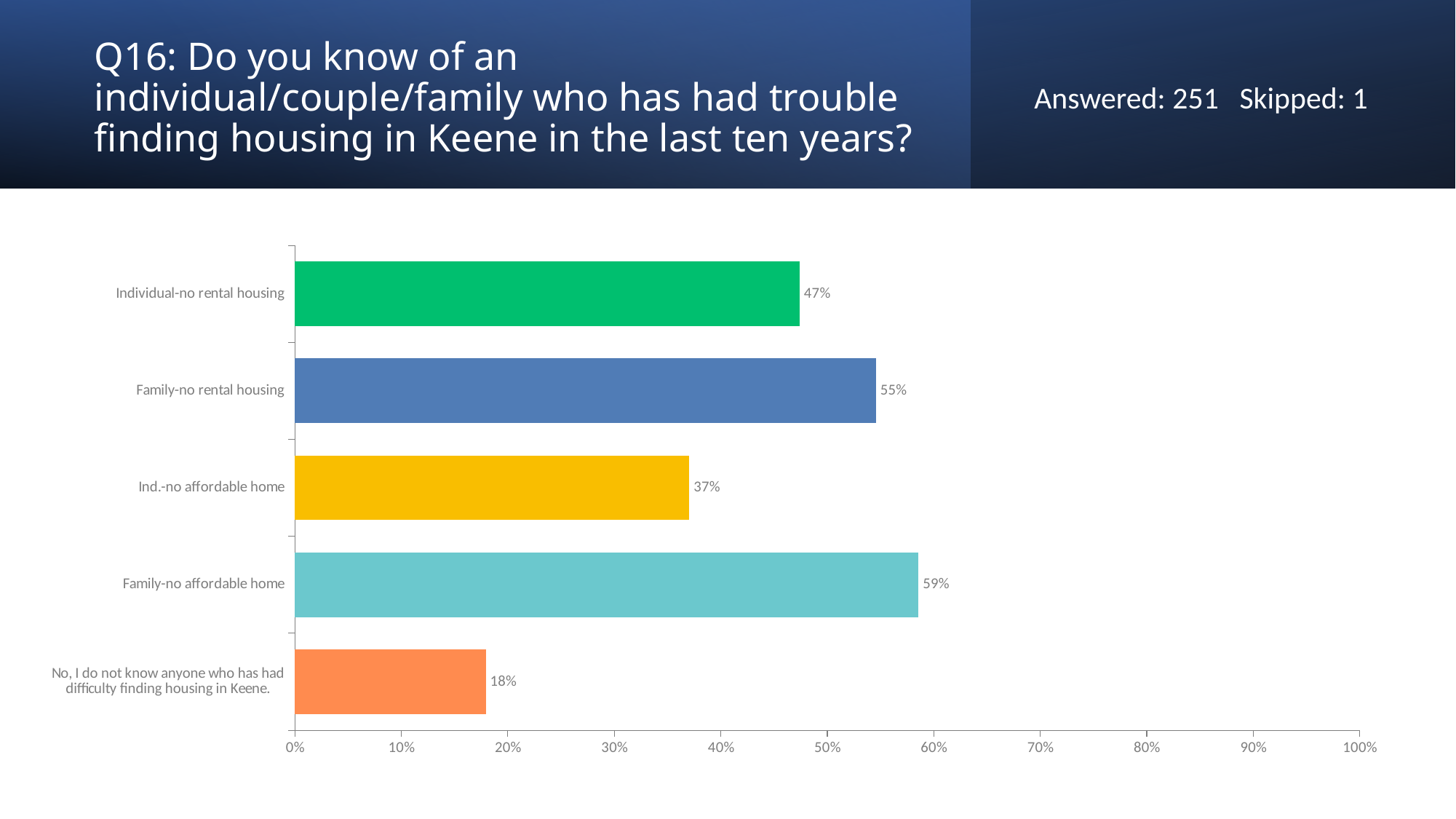
What kind of chart is shown on the slide? bar chart What is the value for Family-no rental housing? 55% What is the value for the category 'No, I do not know anyone who has had difficulty finding housing in Keene.'? 18% Which category has the lowest value? No, I do not know anyone who has had difficulty finding housing in Keene. Is the value for Family-no affordable home greater or less than 50%? greater How many respondents answered the question according to the slide? 251 What is the difference between the values for Family-no affordable home and Ind.-no affordable home? 22% What is the value for Ind.-no affordable home? 37% How many categories are shown in the chart? 5 Which category has the highest value? Family-no affordable home Which is larger, the value for Family-no rental housing or Individual-no rental housing? Family-no rental housing What is the value for Individual-no rental housing? 47%